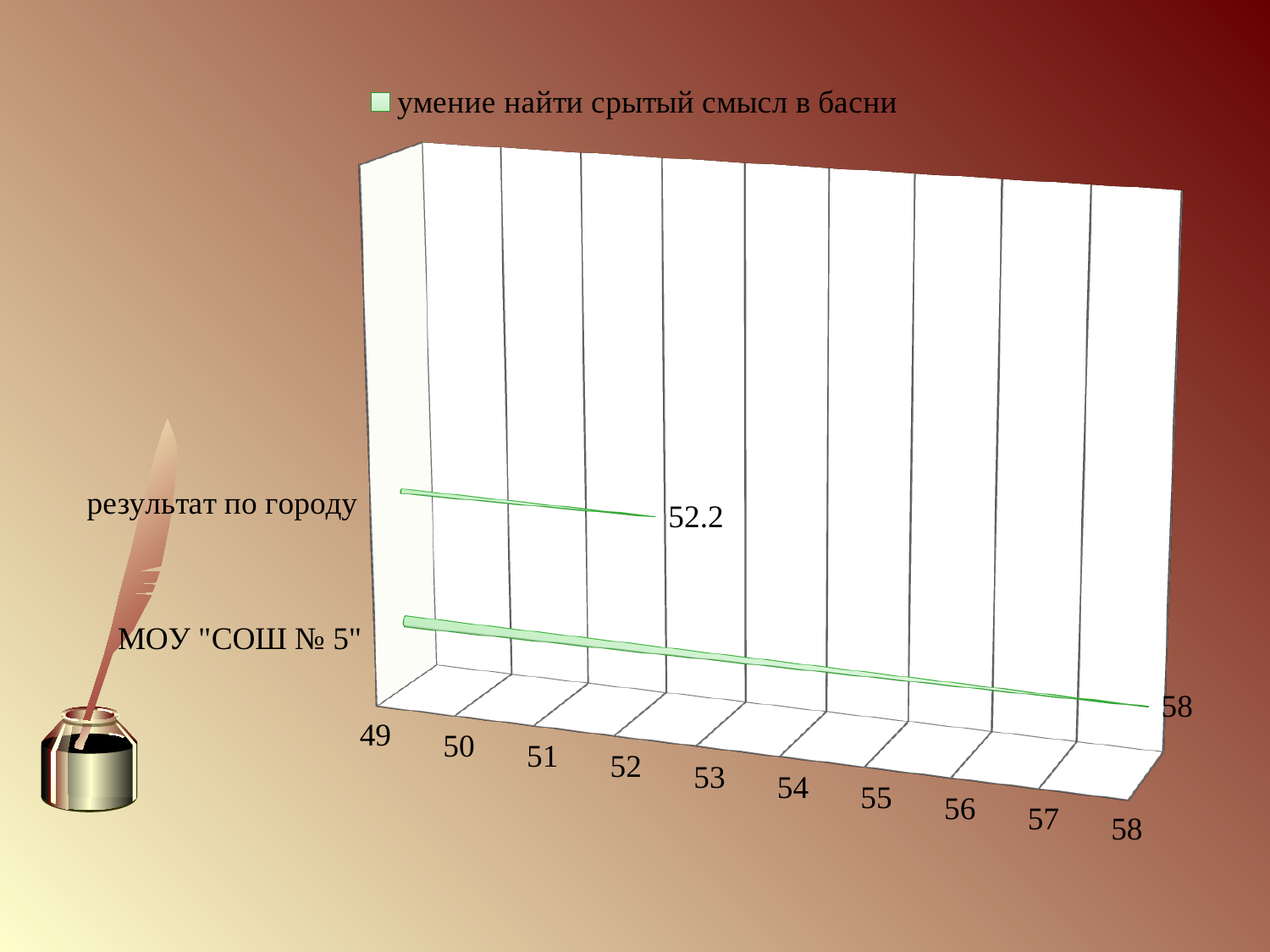
Is the value for результат по городу greater or less than 55? less What is the value for результат по городу? 52.2 Is the value for МОУ "СОШ № 5" greater or less than 55? greater Which is larger, the value for результат по городу or the value for МОУ "СОШ № 5"? МОУ "СОШ № 5" What kind of chart is shown on the slide? bar chart What is the value for МОУ "СОШ № 5"? 58 Which category has the lowest value? результат по городу Which category has the highest value? МОУ "СОШ № 5" What is the difference between the value for МОУ "СОШ № 5" and the value for результат по городу? 5.8 What is the legend entry of the series shown in the chart? умение найти срытый смысл в басни How many series does the legend list? 1 How many categories are shown in the chart? 2